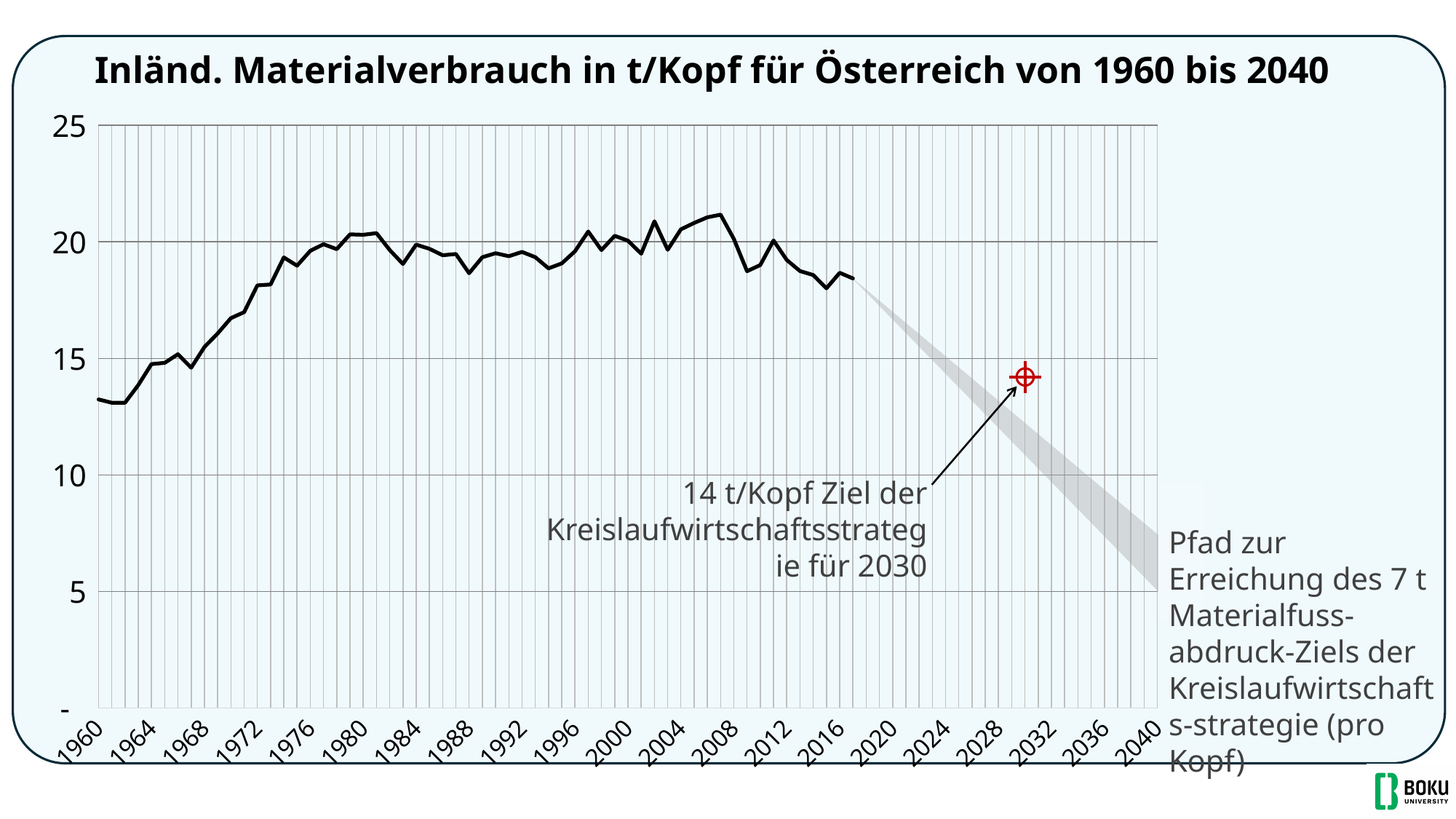
Do the values rise or fall between 1960 and 1980? rise Is the value for 1972 greater or less than 15? greater What target value for 2030 is annotated on the chart? 14 t/Kopf Is the value for 1980 greater or less than 20? greater What is the highest value shown on the y axis? 25 What is the title of the chart? Inländ. Materialverbrauch in t/Kopf für Österreich von 1960 bis 2040 Is the value for 1960 greater or less than 15? less What kind of chart is shown on the slide? line chart What material footprint target per capita is mentioned in the annotation at the right of the chart? 7 t Which year has the larger value, 1960 or 1980? 1980